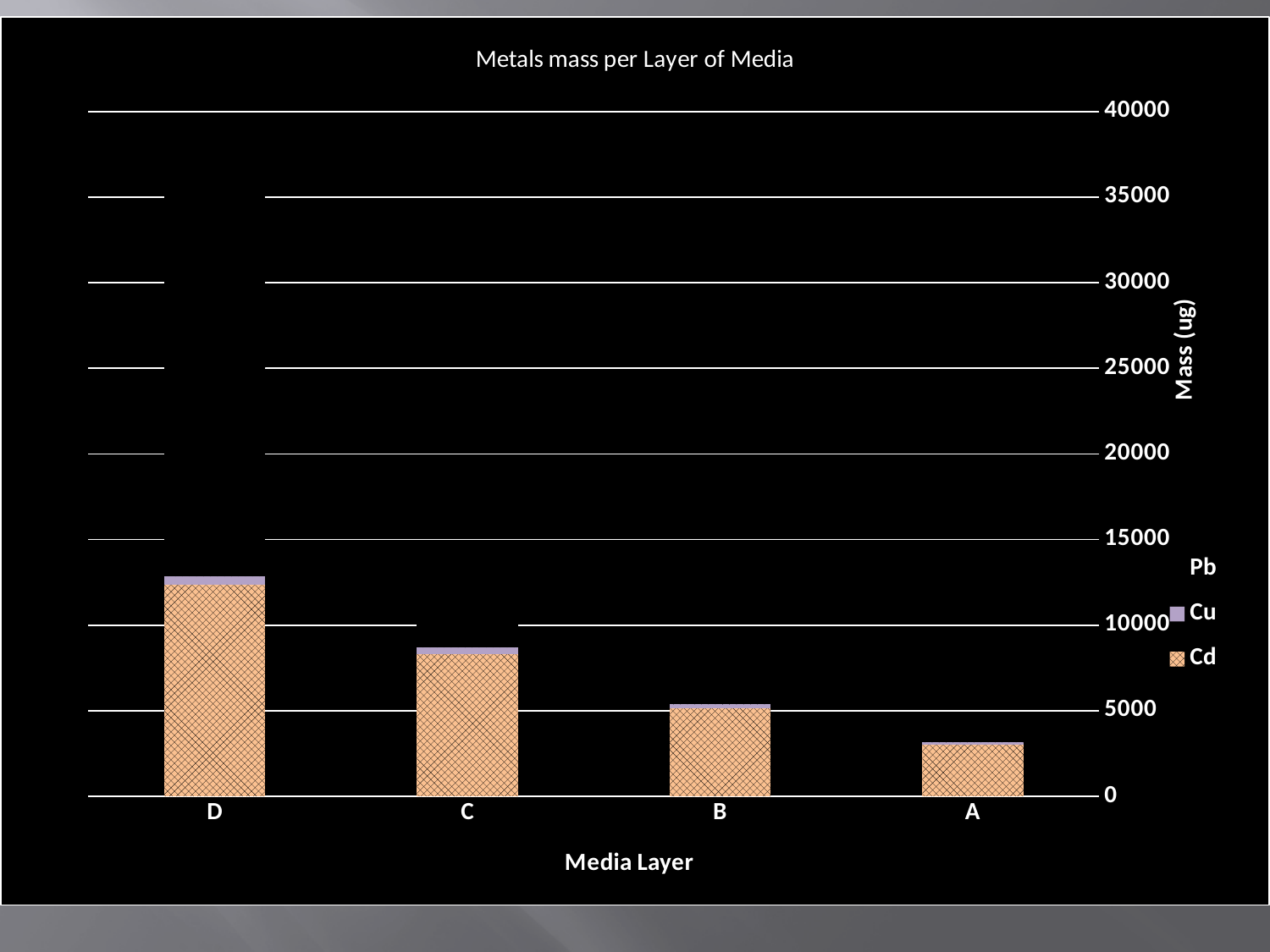
How many media layers are shown on the x axis? 4 Is the total mass for layer A greater or less than 5000? less Which media layer has the highest total metals mass? D Is the total mass for layer D greater or less than 10000? greater What is the title of the chart? Metals mass per Layer of Media What type of chart is shown on the slide? Stacked bar chart Which has a larger total mass, layer C or layer B? C Which media layer has the lowest total metals mass? A What is the label of the y axis? Mass (ug) Do the bar totals rise or fall moving from D to A along the x axis? fall How many series does the legend list? 3